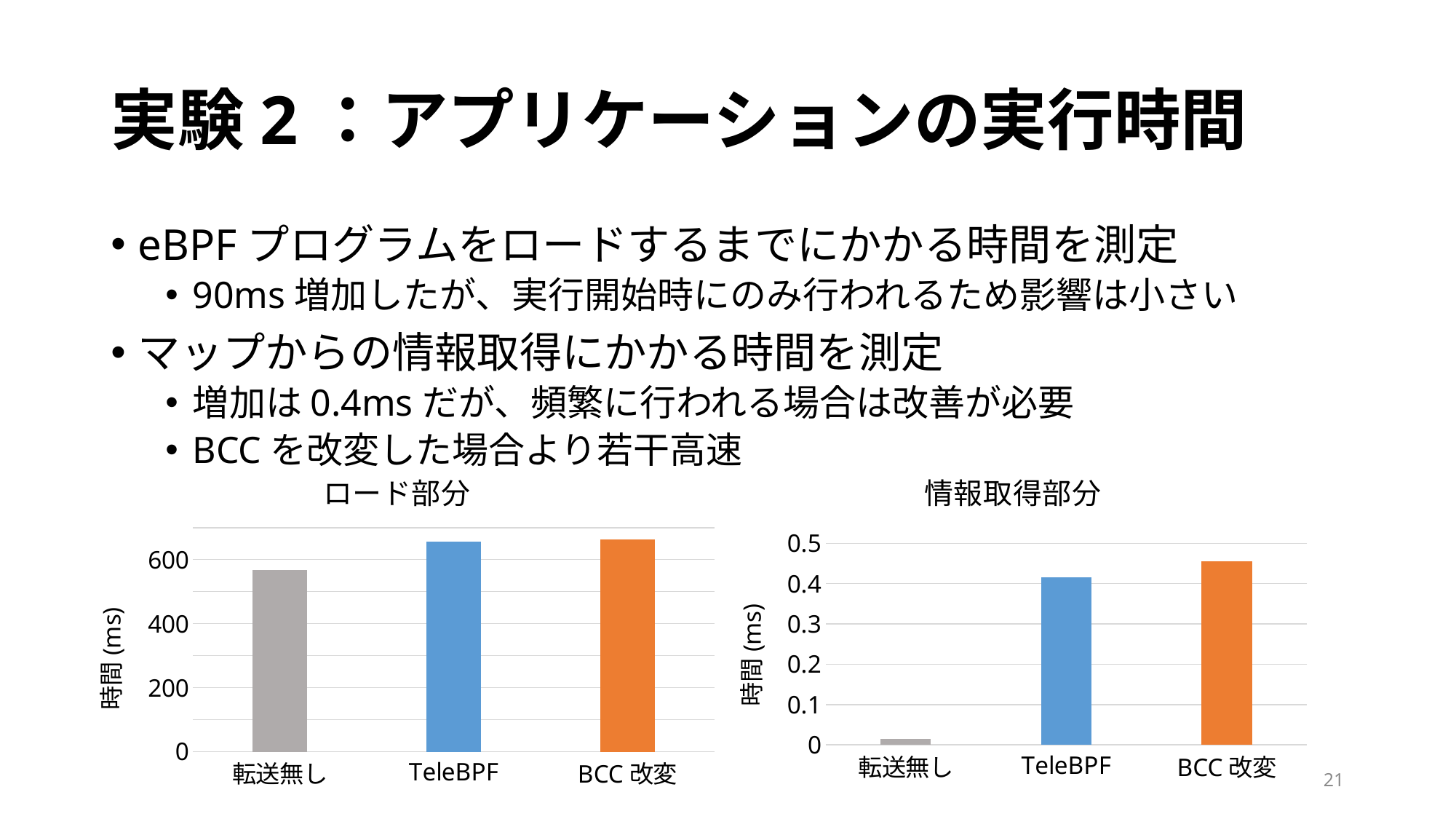
In the ロード部分 chart on the left, which category has the lowest value? 転送無し In the 情報取得部分 chart on the right, is the value for TeleBPF greater or less than 0.4? greater In the ロード部分 chart on the left, is the value for 転送無し greater or less than 600? less In the 情報取得部分 chart on the right, which category has the lowest value? 転送無し In the 情報取得部分 chart on the right, which category has the highest value? BCC 改変 In the 情報取得部分 chart on the right, is the value for 転送無し greater or less than 0.1? less What kind of chart is the ロード部分 chart on the left? bar chart How many categories are shown in the ロード部分 chart on the left? 3 How many categories are shown in the 情報取得部分 chart on the right? 3 In the ロード部分 chart on the left, which is larger, the value for 転送無し or the value for TeleBPF? TeleBPF What is the y-axis label of the ロード部分 chart on the left? 時間 (ms)